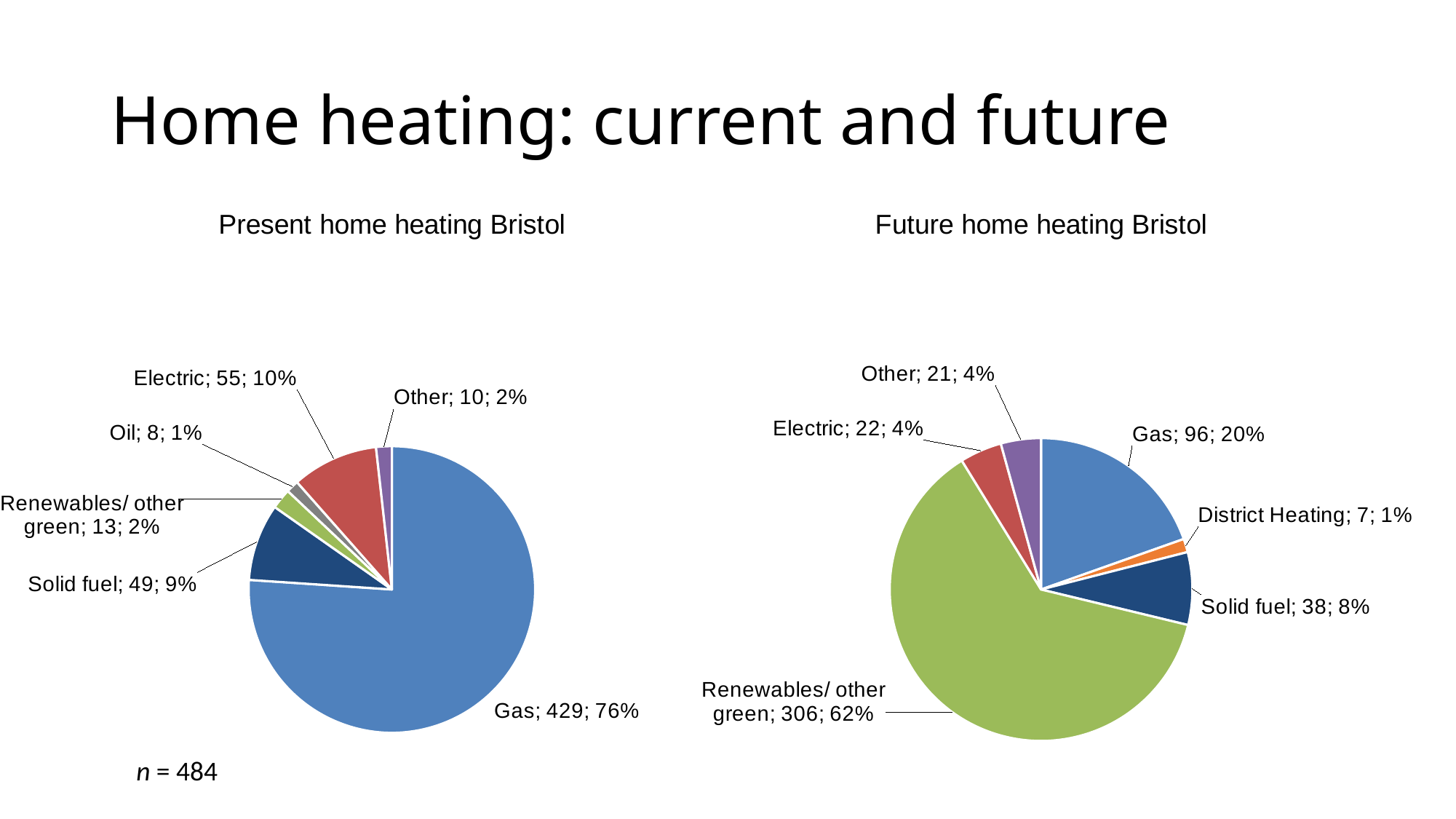
In the 'Future home heating Bristol' chart, which category has the smallest slice? District Heating In the 'Present home heating Bristol' chart, which category has the smallest slice? Oil In the 'Future home heating Bristol' chart, which category has the largest slice? Renewables/ other green In the 'Future home heating Bristol' chart, what share of the pie does Gas represent? 20% In the 'Future home heating Bristol' chart, which is larger, Gas or Solid fuel? Gas In the 'Present home heating Bristol' chart, what is the difference between the values for Electric and Solid fuel? 6 In the 'Future home heating Bristol' chart, what is the value for Renewables/ other green? 306 In the 'Present home heating Bristol' chart, what share of the pie does Electric represent? 10% What sample size (n) is stated on the slide? 484 What kind of chart is the 'Present home heating Bristol' chart? Pie chart How many categories are shown in the 'Future home heating Bristol' chart? 6 In the 'Present home heating Bristol' chart, what is the value for Gas? 429